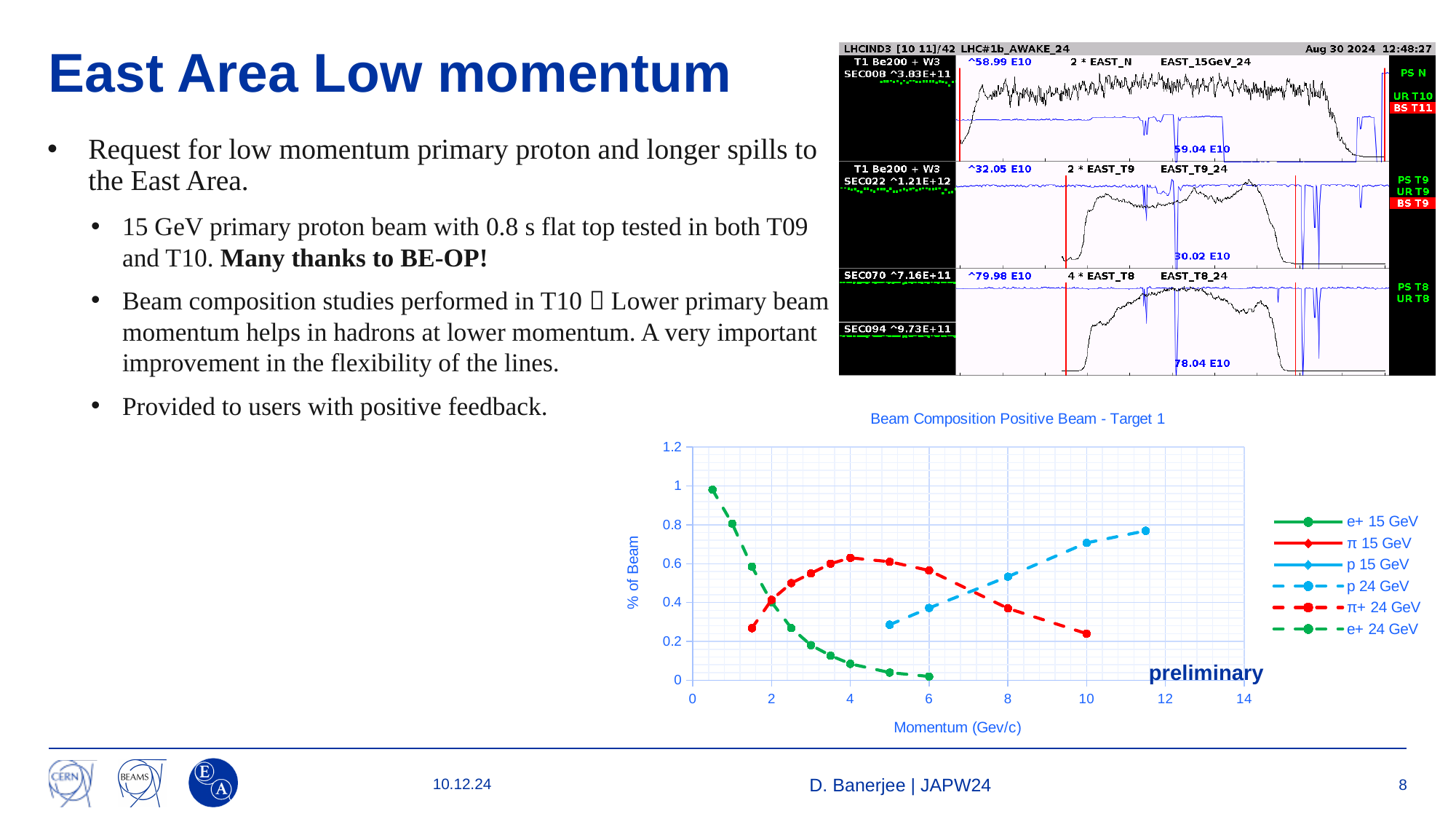
What is the title of the chart at the bottom right of the slide? Beam Composition Positive Beam - Target 1 In the 'Beam Composition Positive Beam - Target 1' chart, does the e+ 24 GeV series rise or fall as momentum increases? fall In the 'Beam Composition Positive Beam - Target 1' chart, which series reaches the highest value on the chart? e+ 24 GeV What is the x-axis label of the 'Beam Composition Positive Beam - Target 1' chart? Momentum (Gev/c) In the 'Beam Composition Positive Beam - Target 1' chart, is the p 24 GeV value at momentum 10 greater or less than 0.6? greater In the 'Beam Composition Positive Beam - Target 1' chart, how many data points are plotted for the p 24 GeV series? 5 In the 'Beam Composition Positive Beam - Target 1' chart, is the π+ 24 GeV value at momentum 10 greater or less than 0.4? less In the 'Beam Composition Positive Beam - Target 1' chart, at momentum 10, which is larger: p 24 GeV or π+ 24 GeV? p 24 GeV In the 'Beam Composition Positive Beam - Target 1' chart, is the e+ 24 GeV value at momentum 6 greater or less than 0.2? less In the 'Beam Composition Positive Beam - Target 1' chart, does the p 24 GeV series rise or fall as momentum increases? rise How many series does the legend of the 'Beam Composition Positive Beam - Target 1' chart list? 6 What kind of chart is 'Beam Composition Positive Beam - Target 1'? line chart